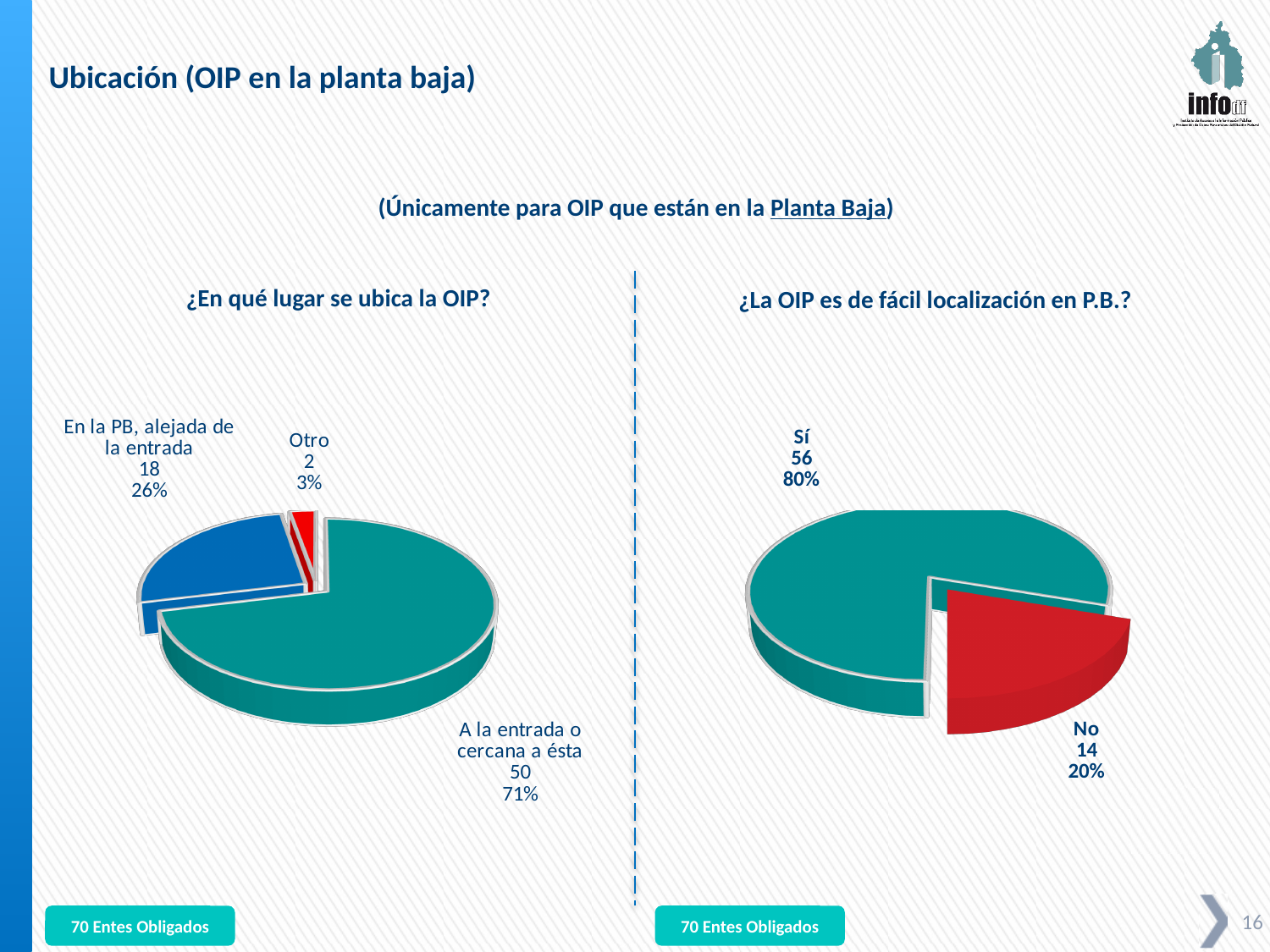
In the chart '¿En qué lugar se ubica la OIP?', how many slices does the pie have? 3 In the chart '¿La OIP es de fácil localización en P.B.?', which is larger, 'Sí' or 'No'? Sí In the chart '¿La OIP es de fácil localización en P.B.?', what colour is the 'No' slice? Red In the chart '¿La OIP es de fácil localización en P.B.?', what percentage share does 'No' have? 20% In the chart '¿En qué lugar se ubica la OIP?', which category has the smallest slice? Otro In the chart '¿En qué lugar se ubica la OIP?', which category has the largest slice? A la entrada o cercana a ésta In the chart '¿La OIP es de fácil localización en P.B.?', how many entities answered 'Sí'? 56 In the chart '¿En qué lugar se ubica la OIP?', what percentage share does 'En la PB, alejada de la entrada' have? 26% What type of chart is used on the right side of the slide, '¿La OIP es de fácil localización en P.B.?'? Pie chart In the chart '¿En qué lugar se ubica la OIP?', how many entities answered 'A la entrada o cercana a ésta'? 50 In the chart '¿En qué lugar se ubica la OIP?', what is the difference between 'A la entrada o cercana a ésta' and 'En la PB, alejada de la entrada'? 32 In the chart '¿En qué lugar se ubica la OIP?', what is the value for 'Otro'? 2